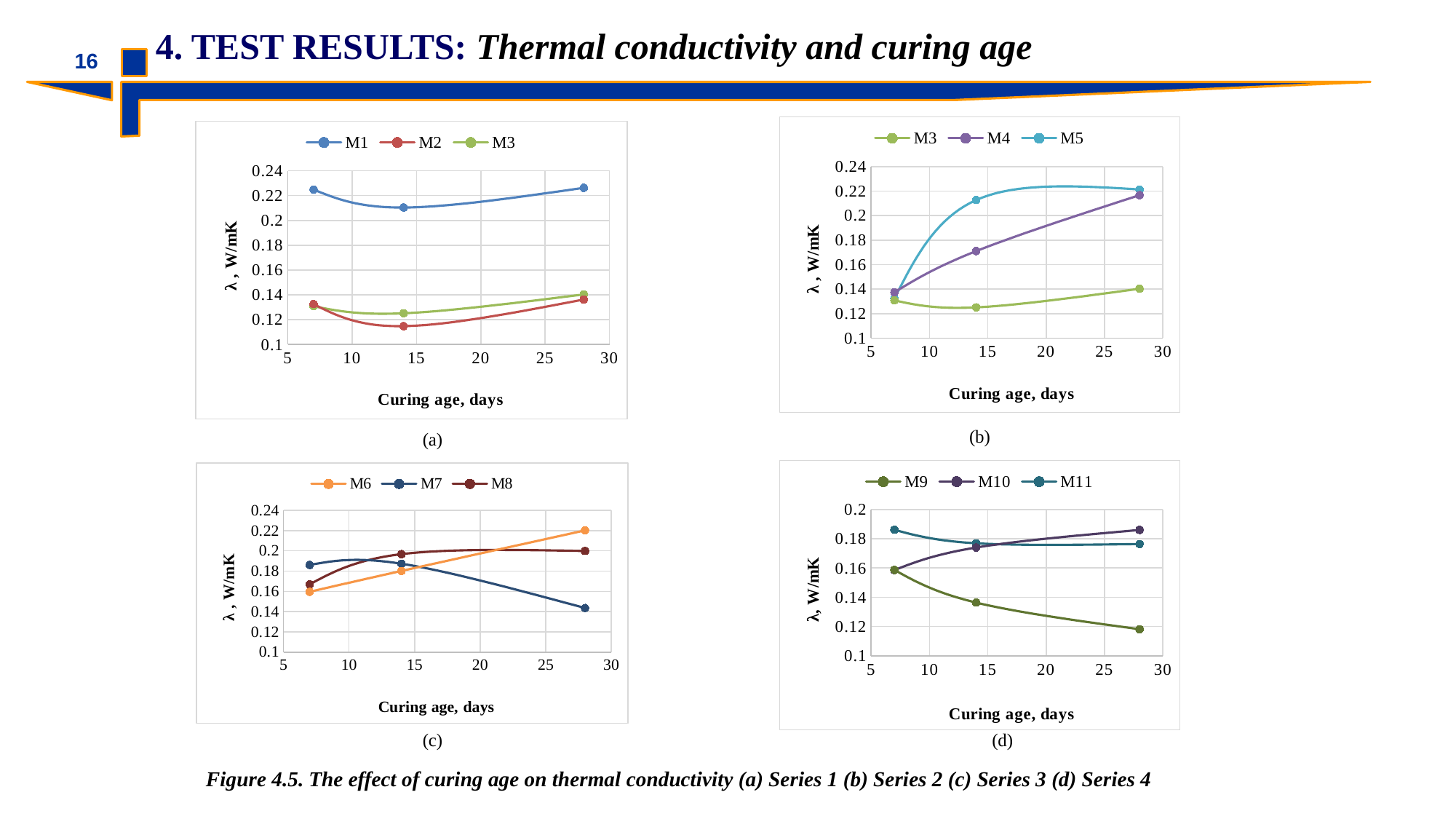
In chart (b), which series has the larger value at 28 days, M3 or M4? M4 In chart (d), how many data points are plotted for the M10 series? 3 In chart (d), the bottom-right chart, does the M9 series rise or fall as curing age increases? fall In chart (d), is the value for M10 at 28 days greater or less than 0.18? greater In chart (a), which series has the highest values across all curing ages? M1 In chart (a), is the value for M2 at 14 days greater or less than 0.12? less How many series does the legend of chart (b), the top-right chart, list? 3 In chart (a), is the value for M1 at 7 days greater or less than 0.2? greater What is the x-axis title of chart (a)? Curing age, days In chart (c), which series has the larger value at 28 days, M6 or M7? M6 In chart (c), the bottom-left chart, does the M6 series rise or fall as curing age increases? rise What kind of chart is chart (a), the top-left chart? line chart